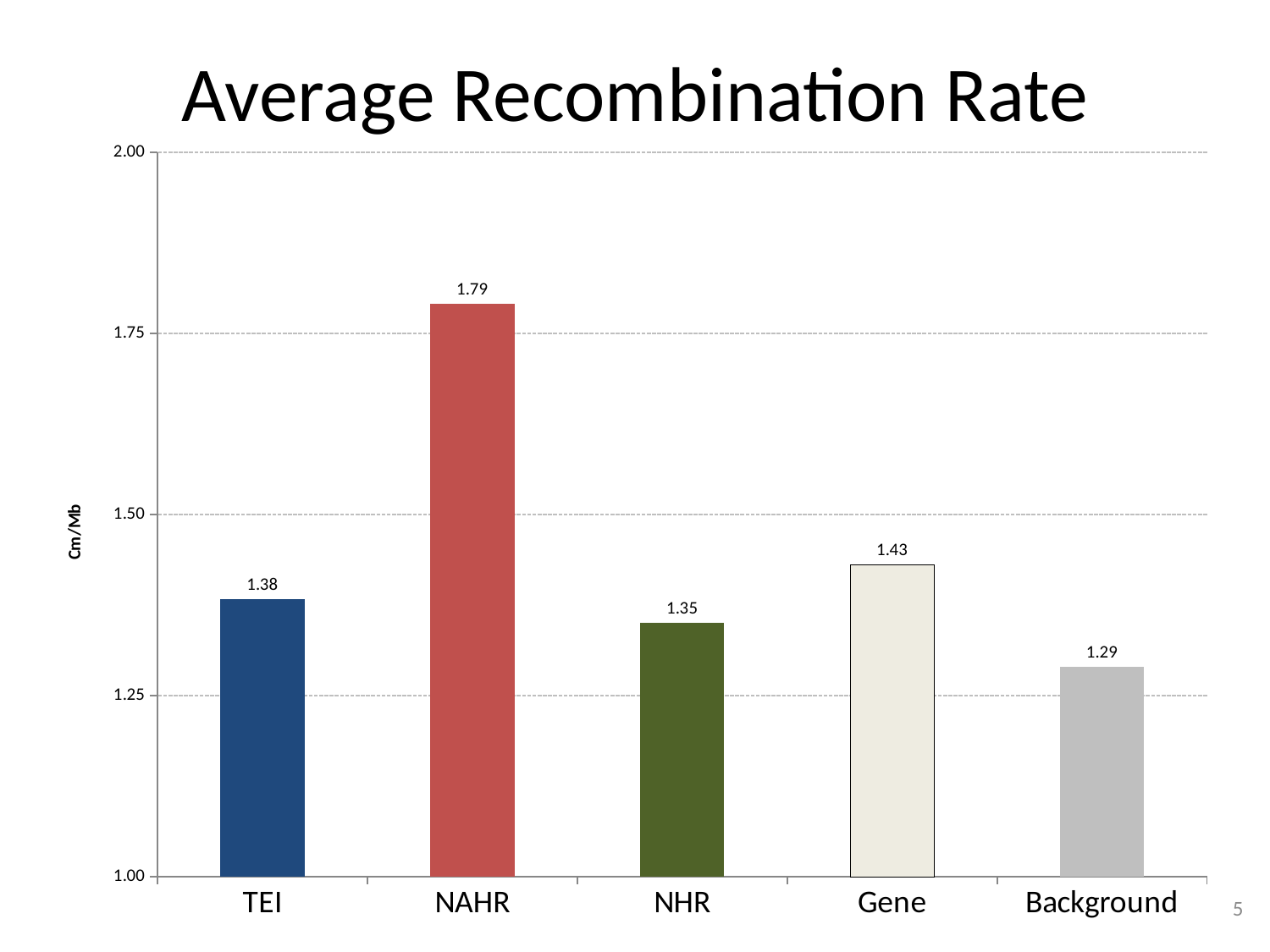
What is the value for Background? 1.29 What is the value for Gene? 1.43 What is the difference between the values for NAHR and TEI? 0.41 How many categories are shown on the x axis? 5 Which category has the highest value? NAHR Which is larger, the value for TEI or the value for NHR? TEI What kind of chart is shown on the slide? bar chart What is the label on the vertical axis? Cm/Mb Is the value for Gene greater or less than 1.50? less What is the value for NAHR? 1.79 Which category has the lowest value? Background What is the difference between the values for Gene and Background? 0.14